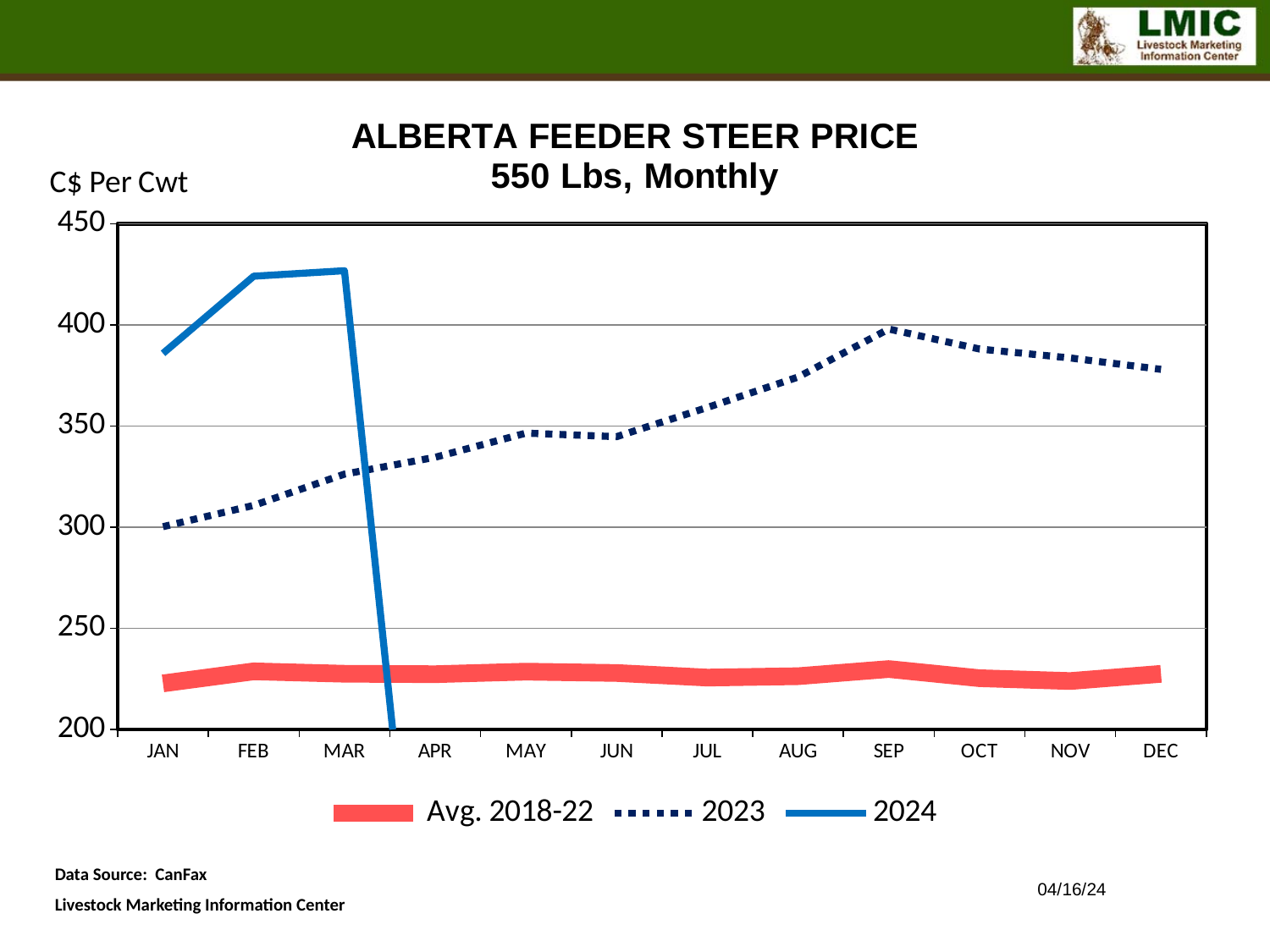
What unit label is shown on the y axis of the chart? C$ Per Cwt Is the Avg. 2018-22 value for SEP greater or less than 250? less How many months are shown along the x axis? 12 What kind of chart is shown on the slide? line chart Does the 2023 series rise or fall from JAN to SEP? rise In which month is the 2023 series at its lowest value? JAN Which series has the higher value in JAN, 2023 or 2024? 2024 Is the 2023 value for DEC greater or less than 350? greater Is the 2024 value for FEB greater or less than 400? greater In which month does the 2023 series reach its highest value? SEP How many series does the legend list? 3